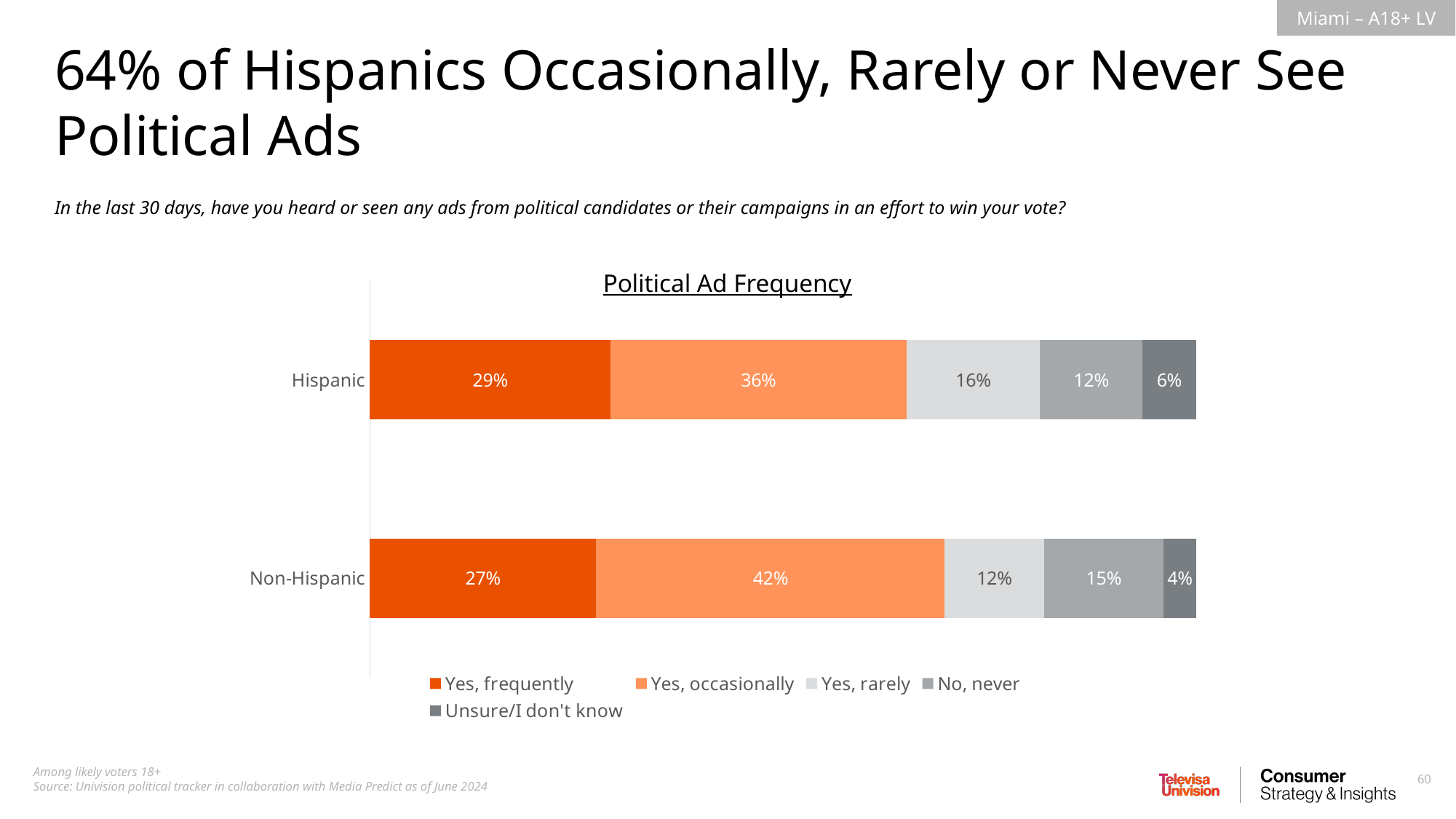
What is the title of the chart? Political Ad Frequency What is the 'Unsure/I don't know' value for Non-Hispanic respondents? 4% Which response category has the highest value for Hispanic respondents? Yes, occasionally What is the 'No, never' value for Hispanic respondents? 12% How many groups (bars) are shown in the chart? 2 Which group has a larger 'Yes, rarely' value, Hispanic or Non-Hispanic? Hispanic How many series does the legend list? 5 What percentage of Non-Hispanic respondents said they see political ads occasionally? 42% What is the difference between the 'Yes, occasionally' values for Non-Hispanic and Hispanic respondents? 6% What percentage of Hispanic respondents said they see political ads frequently? 29% What kind of chart is shown on the slide? Stacked bar chart Which response category has the lowest value for Non-Hispanic respondents? Unsure/I don't know